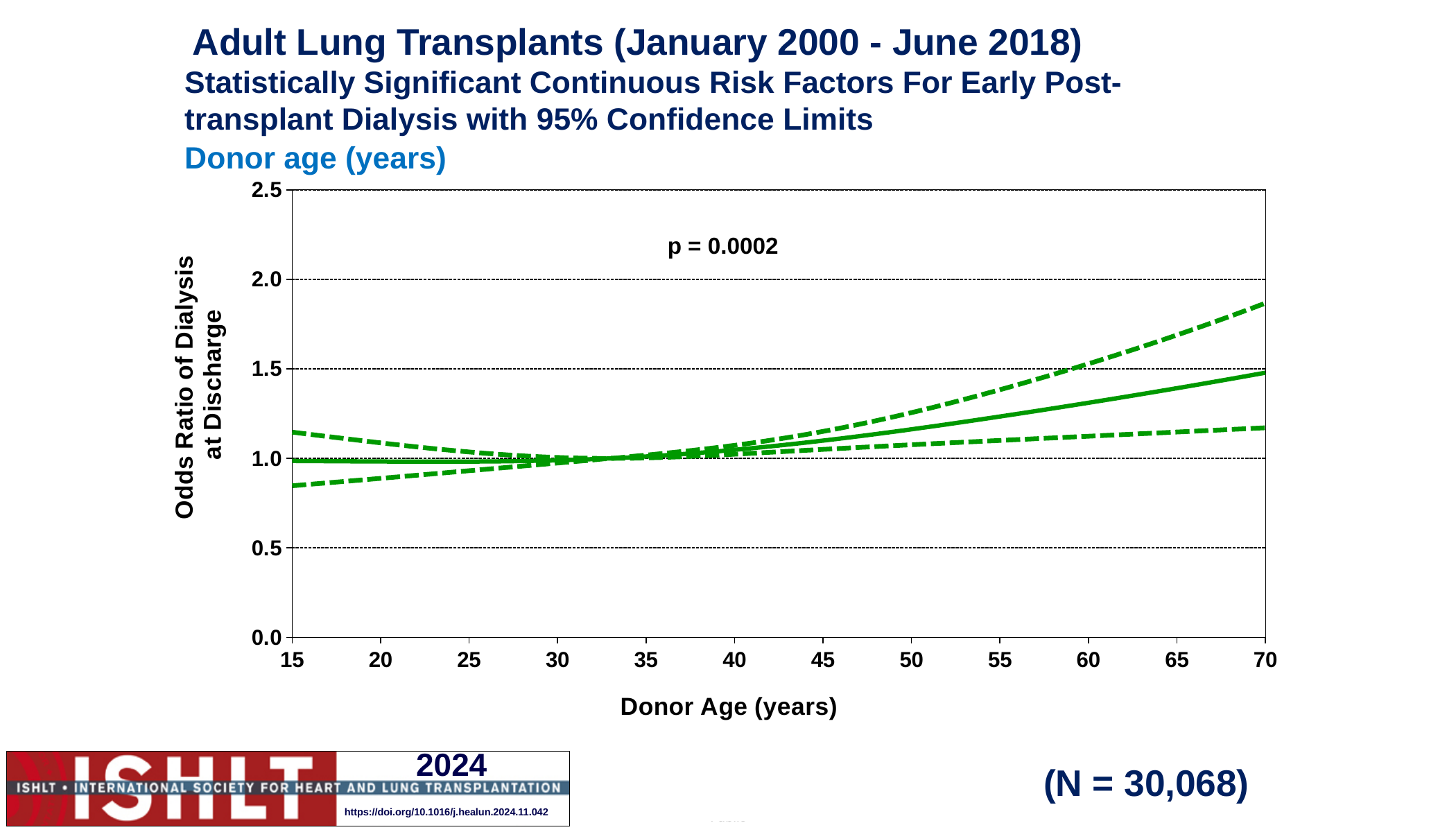
Is the value of the upper dashed confidence limit at donor age 70 greater or less than 1.5? greater Does the solid odds ratio line rise or fall as donor age increases from 40 to 70 years? rise What is the highest donor age shown on the x axis? 70 What kind of chart is shown on the slide? line chart Is the value of the lower dashed confidence limit at donor age 15 greater or less than 1.0? less Is the value of the solid odds ratio line at donor age 60 greater or less than 1.5? less How many lines are plotted on the chart? 3 What p-value is printed on the chart? p = 0.0002 What is the maximum value shown on the y axis? 2.5 What is the label of the x axis? Donor Age (years)